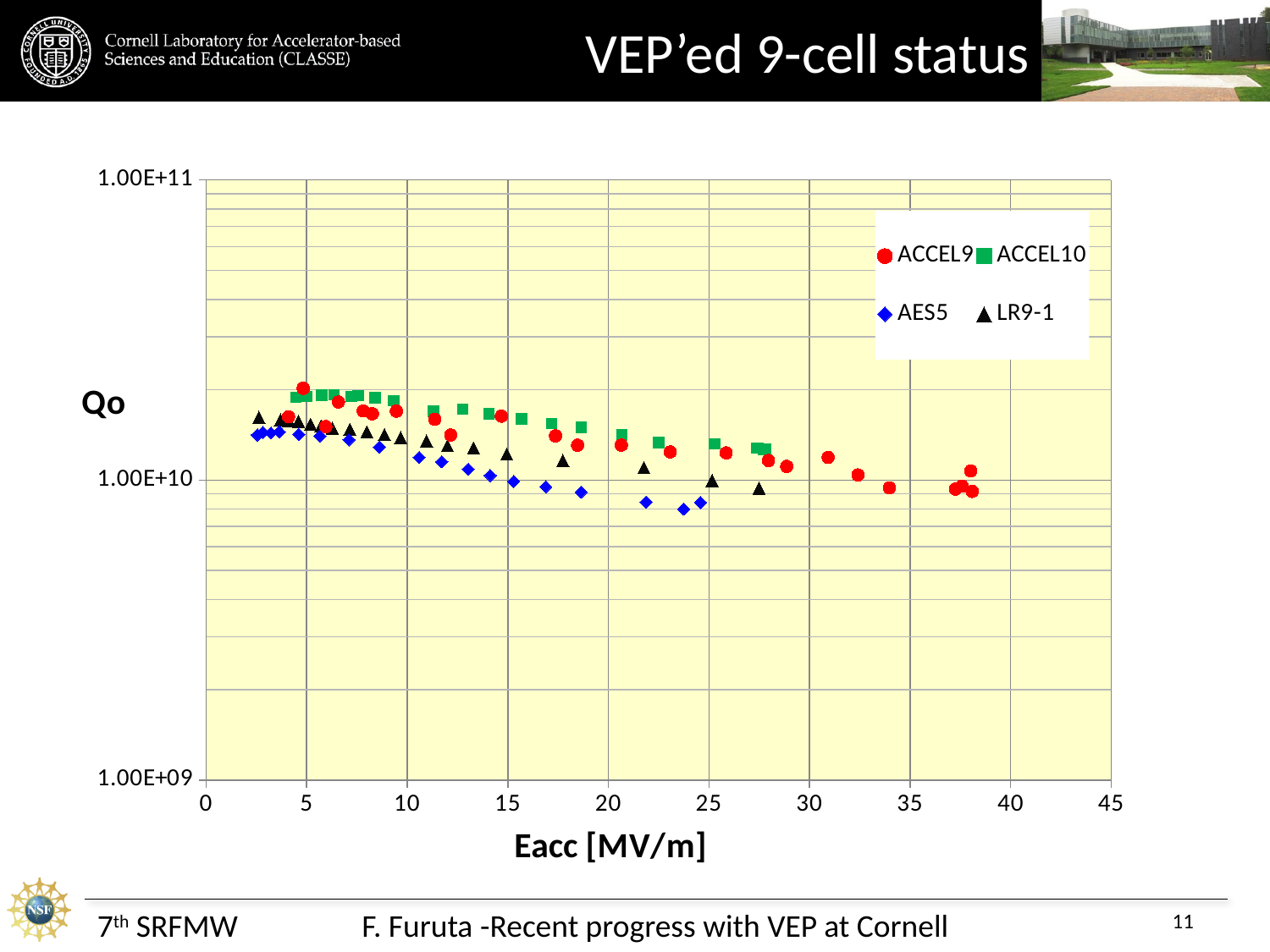
What are the names of the series listed in the legend? ACCEL9, ACCEL10, AES5, LR9-1 Is the Qo value for ACCEL10 at about 10 MV/m greater or less than 1.00E+10? greater What kind of chart is shown on the slide? scatter chart At about 15 MV/m, which series has the higher Qo, ACCEL10 or AES5? ACCEL10 Is the Qo value for ACCEL9 at about 38 MV/m greater or less than 1.00E+11? less Does Qo rise or fall as Eacc increases for the ACCEL9 series? fall Which series has the lowest Qo values on the chart, around 24 MV/m? AES5 What is the label of the x axis? Eacc [MV/m] Does Qo rise or fall as Eacc increases for the AES5 series? fall How many series does the legend list? 4 Is the Qo value for AES5 at about 24 MV/m greater or less than 1.00E+10? less Which series reaches the highest Eacc values on the chart? ACCEL9